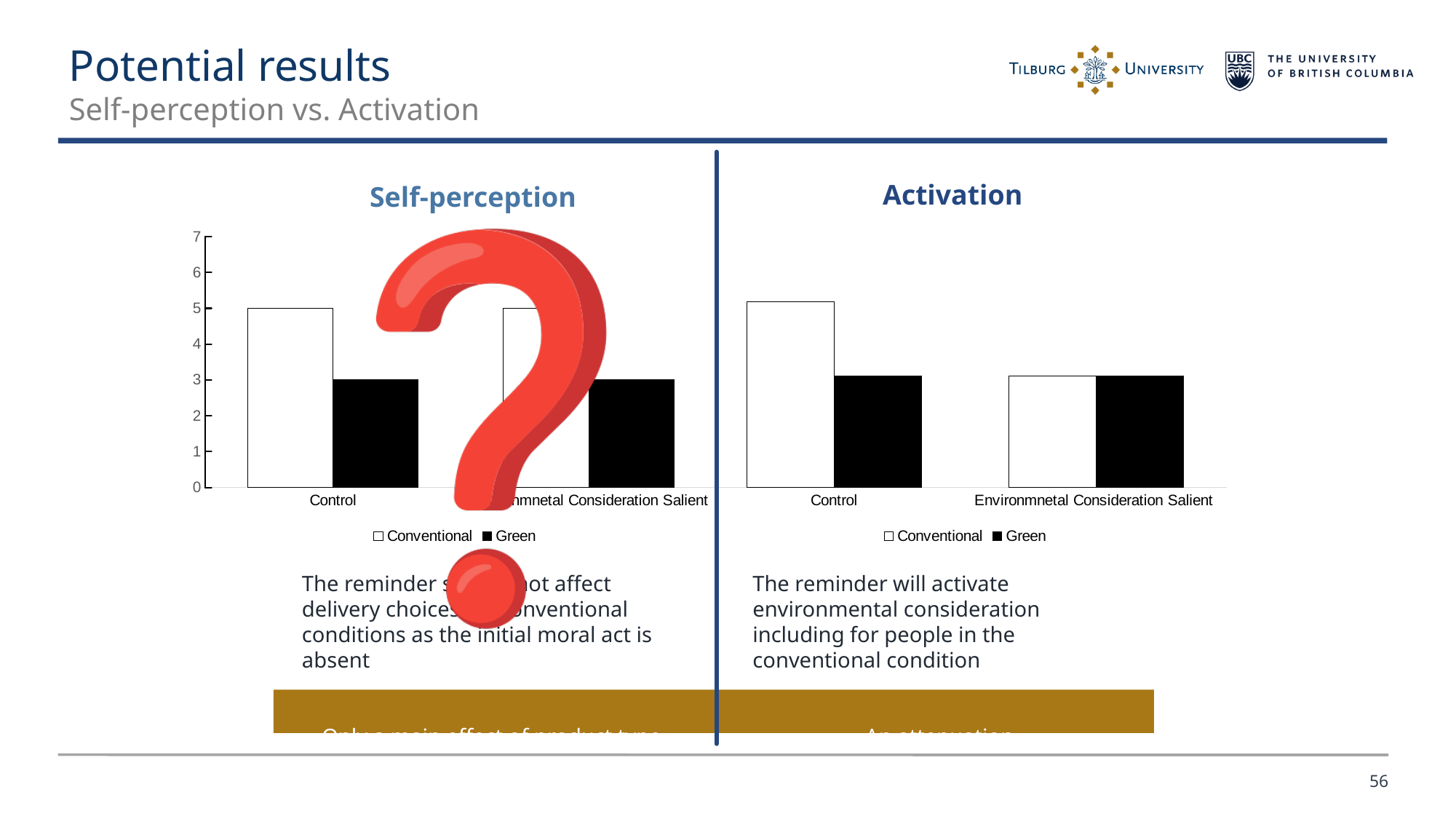
Which series is shown in black in the Activation chart's legend? Green How many categories are shown on the x axis of the Activation chart? 2 What is the highest value shown on the y axis of the Self-perception chart? 7 In the Self-perception chart, what is the value of the Conventional bar for Control? 5 In the Self-perception chart, what is the difference between the Conventional and Green bars for Control? 2 In the Activation chart, which category has the highest Conventional bar? Control In the Self-perception chart, which series has the higher value for Control, Conventional or Green? Conventional In the Self-perception chart, what is the value of the Green bar for Control? 3 How many series does the legend of the Activation chart list? 2 In the Self-perception chart, is the Green bar for Environmnetal Consideration Salient greater or less than 4? less In the Activation chart, which series has the higher value for Control, Conventional or Green? Conventional What type of chart is the Self-perception chart? Bar chart